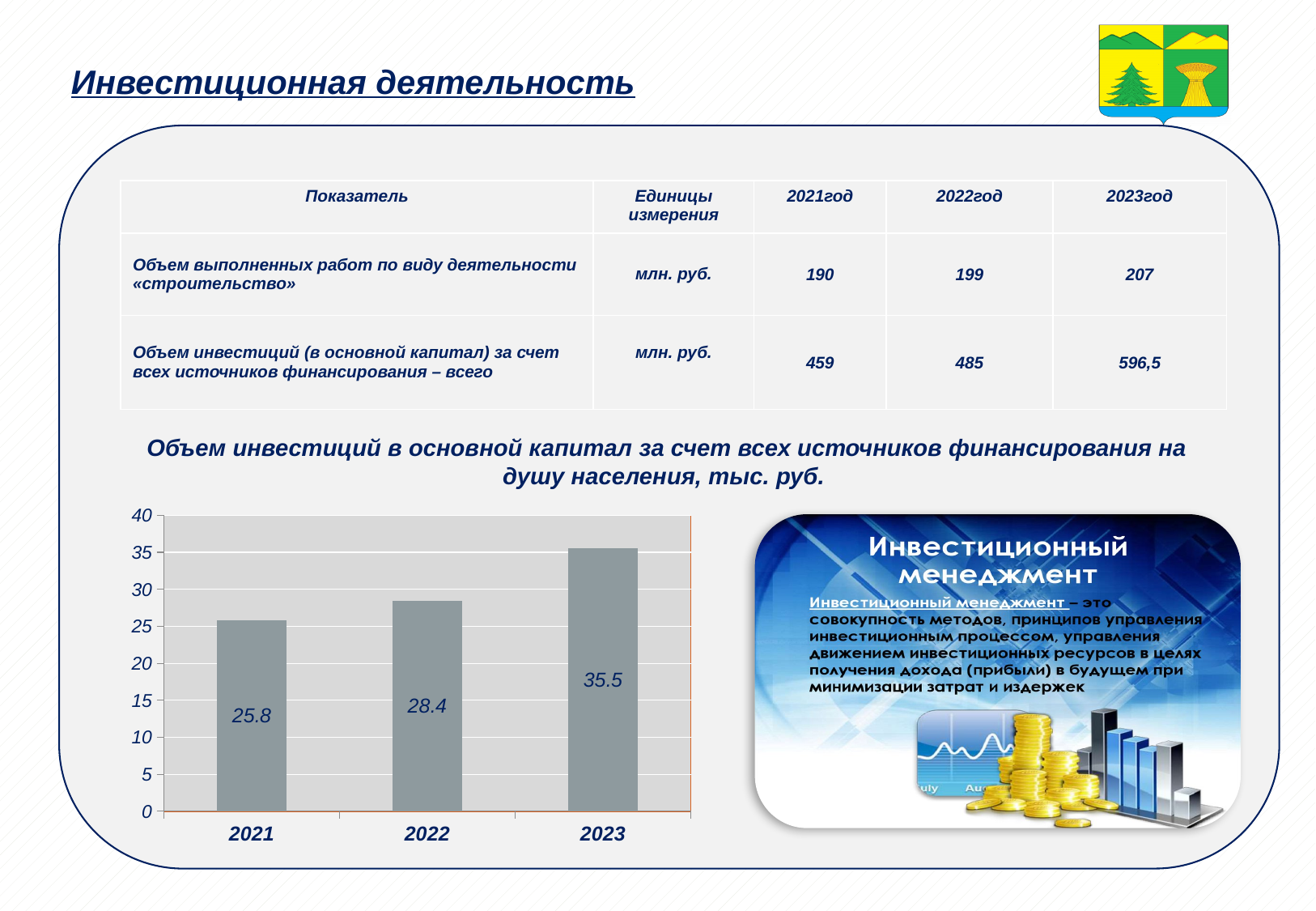
How many years are shown on the x axis of the bar chart? 3 What is the value for 2022 in the bar chart? 28.4 Is the value for 2023 in the bar chart greater or less than 30? greater Do the values in the bar chart rise or fall from 2021 to 2023? rise Which year has the highest value in the bar chart? 2023 Which year has the lowest value in the bar chart? 2021 What is the difference between the 2022 and 2021 values in the bar chart? 2.6 What is the value for 2021 in the bar chart? 25.8 What kind of chart is shown on the slide? bar chart Which is larger in the bar chart, the value for 2022 or the value for 2023? 2023 What is the difference between the 2023 and 2021 values in the bar chart? 9.7 What is the value for 2023 in the bar chart? 35.5